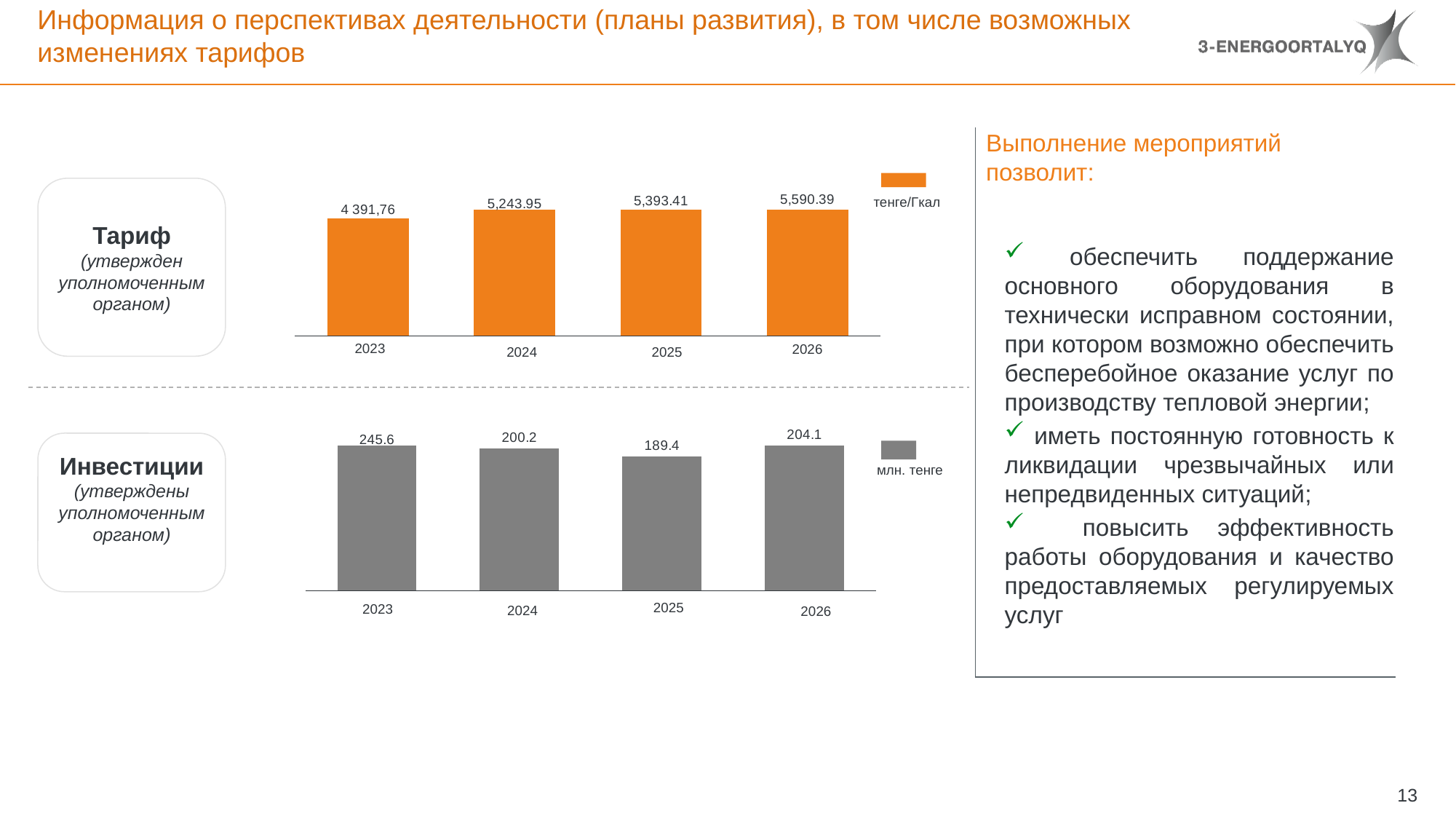
In the Инвестиции chart, which is larger: the value for 2024 or the value for 2026? 2026 In the Инвестиции chart, what is the difference between the 2023 and 2025 values? 56.2 In the Инвестиции chart, which year has the lowest investment value? 2025 In the Инвестиции chart, what is the investment value for 2025? 189.4 In the Тариф chart, what is the tariff value for 2026? 5,590.39 In the Инвестиции chart, which year has the highest investment value? 2023 In the Тариф chart, what is the tariff value for 2024? 5,243.95 In the Тариф chart, what is the tariff value for 2023? 4 391,76 In the Тариф chart, which year has the highest tariff value? 2026 In the Тариф chart, what is the difference between the 2026 and 2024 values? 346.44 How many years are shown in the Тариф chart? 4 What unit is shown in the legend of the Инвестиции chart? млн. тенге